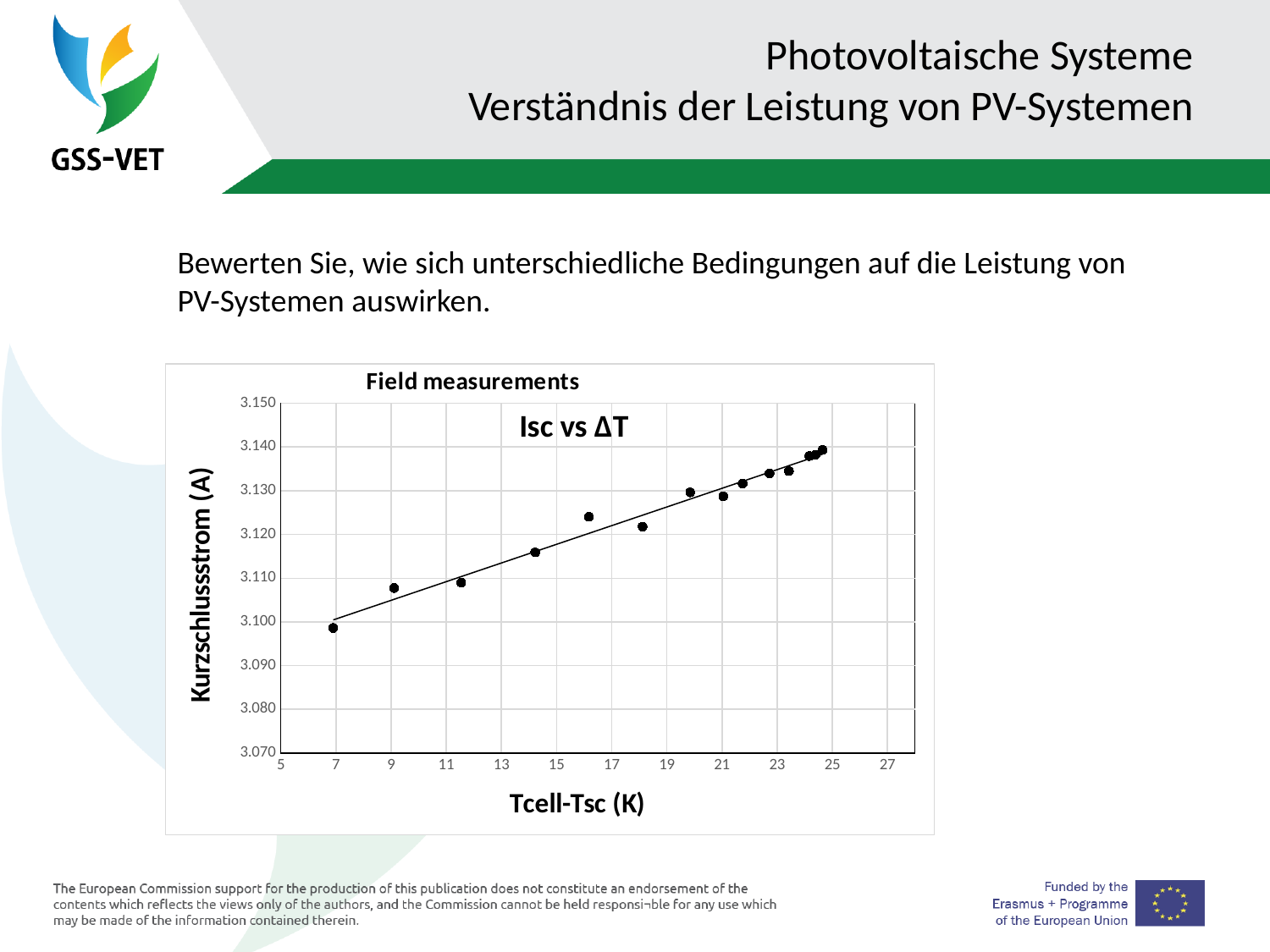
Which point has the highest short-circuit current: the one at about 7 K or the one at about 24 K? the one at about 24 K Do the plotted values rise or fall as Tcell-Tsc increases along the x axis? rise Is the value for the point at about 16 K greater or less than 3.120? greater What is the label of the y axis of the chart? Kurzschlussstrom (A) Is the value for the point at about 14 K greater or less than 3.110? greater What kind of chart is shown on the slide? scatter chart Is the value for the point at about 7 K greater or less than 3.110? less